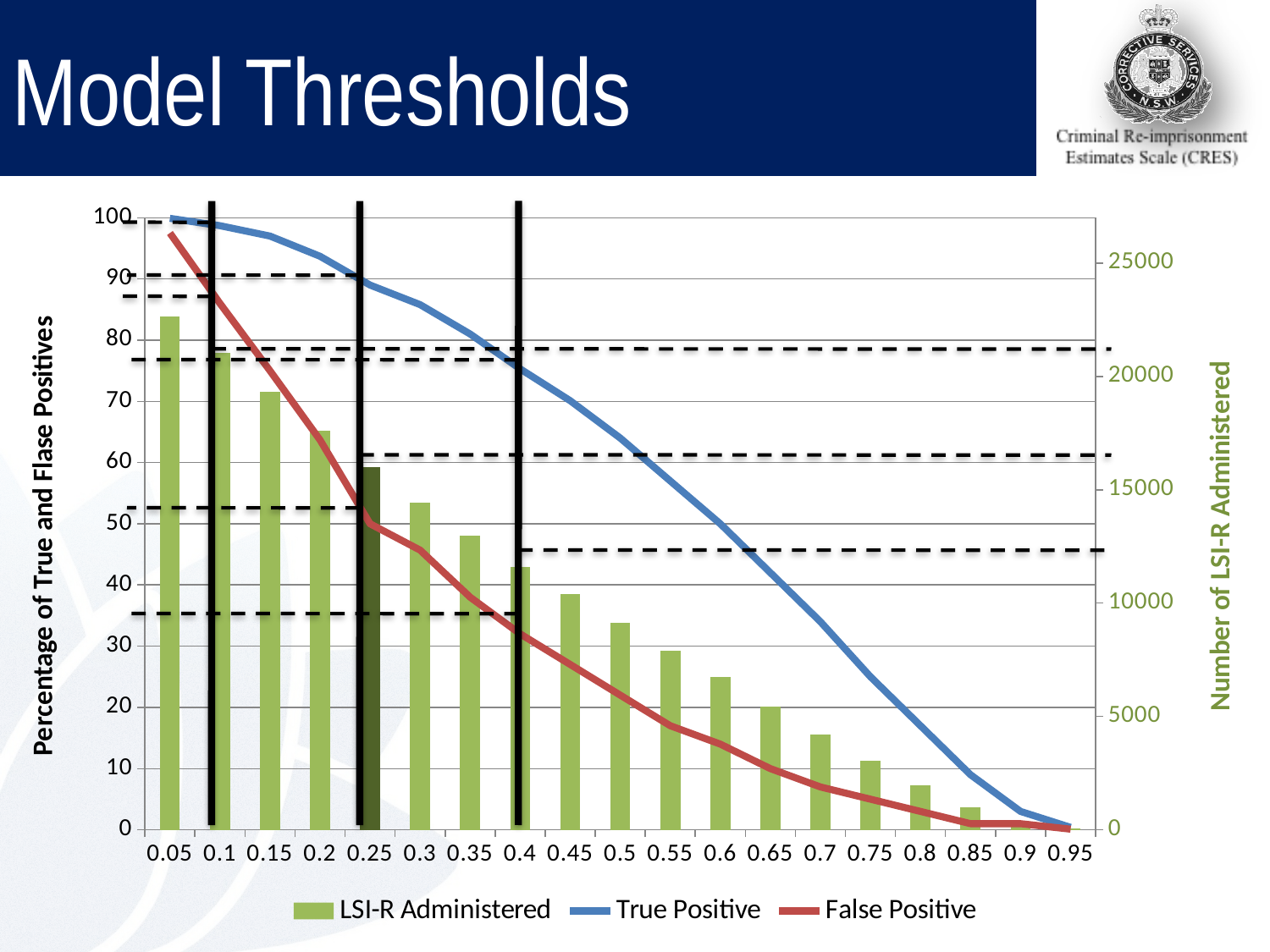
At which x-axis value is the LSI-R Administered bar lowest? 0.95 Is the True Positive value at 0.4 greater or less than 70? greater Is the LSI-R Administered value at 0.05 greater or less than 20000? greater Is the False Positive value at 0.5 greater or less than 30? less What is the title of the right-hand vertical axis? Number of LSI-R Administered At which x-axis value is the LSI-R Administered bar highest? 0.05 What kind of chart is shown on the slide? Combined bar and line chart How many series does the chart legend list? 3 At 0.5, which is larger: the True Positive value or the False Positive value? True Positive How many threshold values are shown along the x axis? 19 Do the LSI-R Administered bars rise or fall as the x-axis value increases? Fall